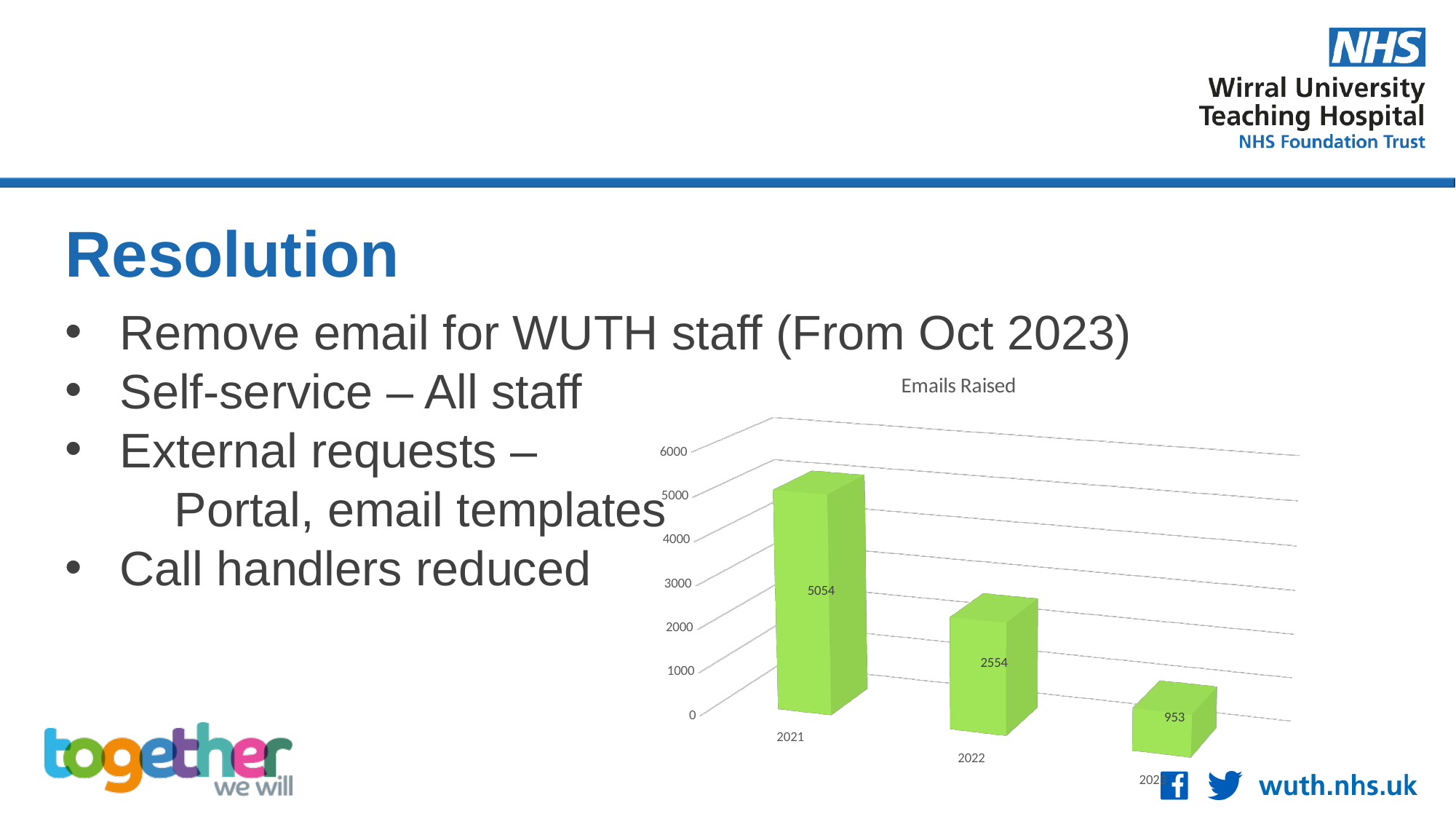
Which year had the highest number of emails raised? 2021 Do the values rise or fall from 2021 to 2023? fall What is the difference between the emails raised in 2021 and 2022? 2500 How many years are shown on the chart? 3 How many emails were raised in 2021? 5054 How many emails were raised in 2022? 2554 Which year had the lowest number of emails raised? 2023 Which year had more emails raised, 2022 or 2023? 2022 How many emails were raised in 2023? 953 What is the title of the chart? Emails Raised What type of chart is shown on the slide? bar chart What is the difference between the emails raised in 2022 and 2023? 1601